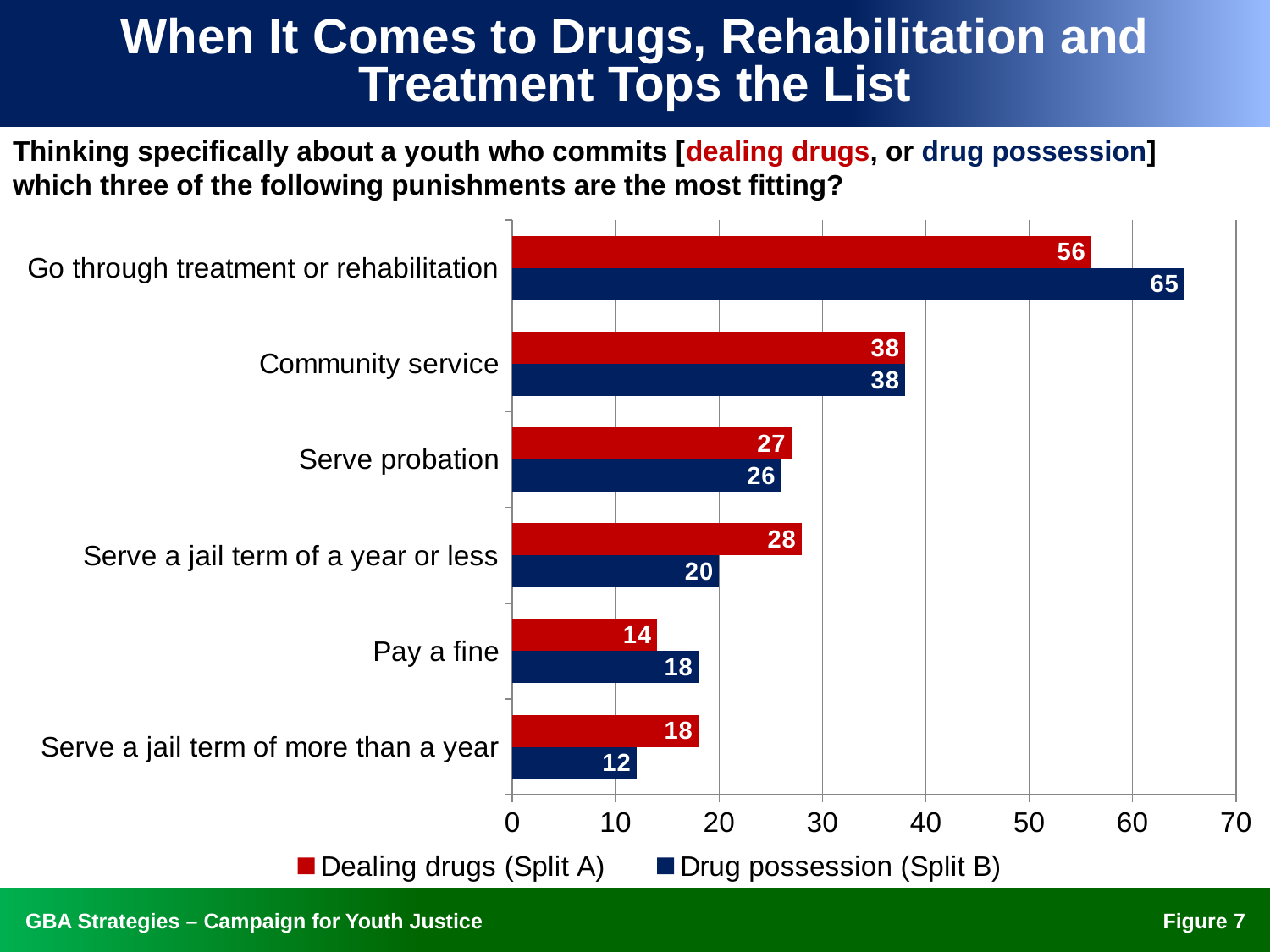
What is the value for "Go through treatment or rehabilitation" in the Drug possession (Split B) series? 65 What kind of chart is shown on the slide? Bar chart Which category has the highest value in the Dealing drugs (Split A) series? Go through treatment or rehabilitation How many categories are shown on the chart? 6 For "Serve a jail term of more than a year", which series has the larger value: Dealing drugs (Split A) or Drug possession (Split B)? Dealing drugs (Split A) Which category has the lowest value in the Drug possession (Split B) series? Serve a jail term of more than a year What is the difference between the Drug possession (Split B) and Dealing drugs (Split A) values for "Go through treatment or rehabilitation"? 9 Is the Dealing drugs (Split A) value for "Community service" greater or less than 30? greater How many series does the legend list? 2 What is the value for "Serve a jail term of a year or less" in the Drug possession (Split B) series? 20 What is the value for "Pay a fine" in the Dealing drugs (Split A) series? 14 Which colour represents the Drug possession (Split B) series? Dark blue